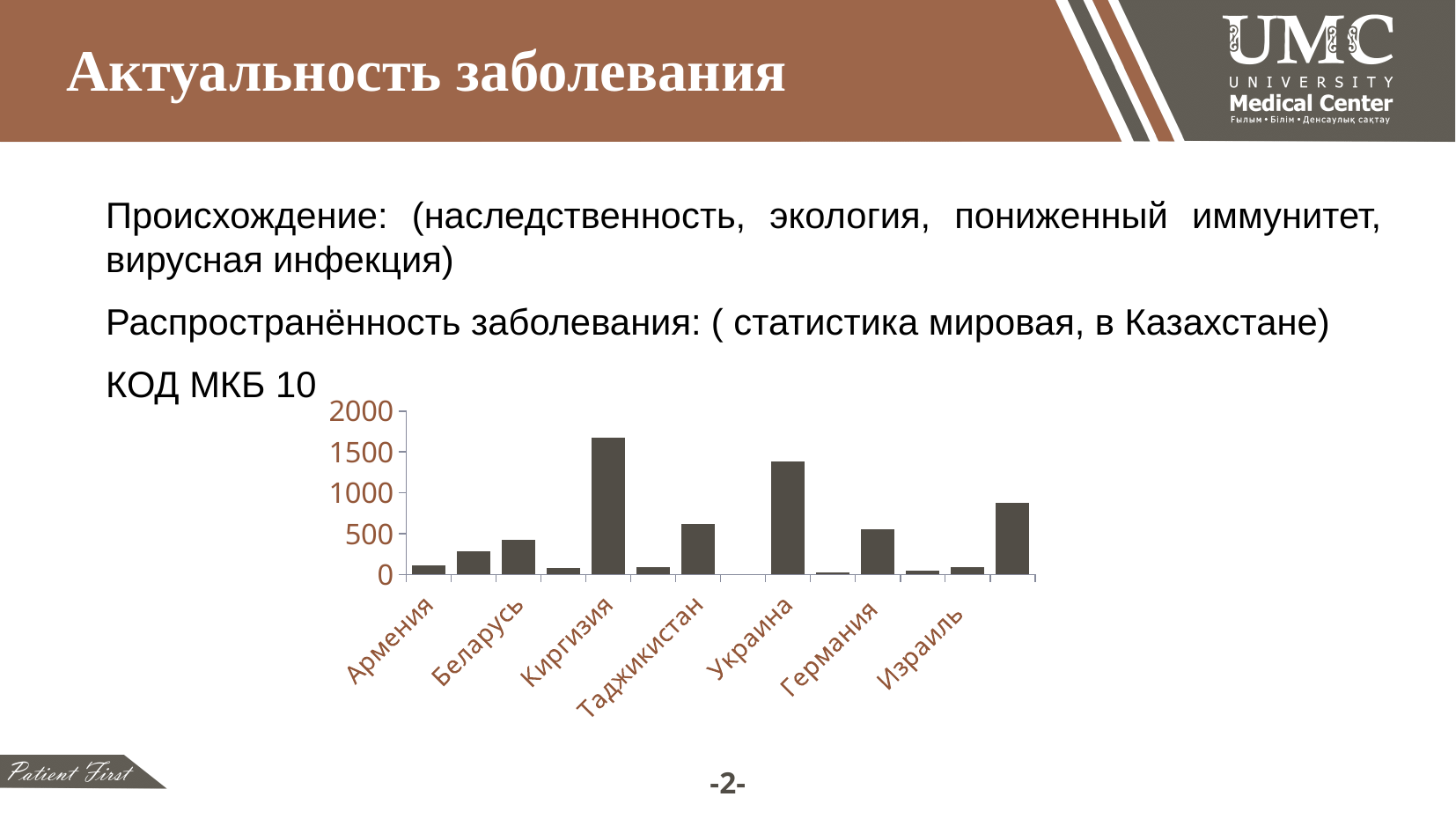
Is the value for Армения greater or less than 500? less Is the value for Киргизия greater or less than 1500? greater Is the value for Таджикистан greater or less than 1000? less What is the highest value shown on the vertical axis of the chart? 2000 Which has the larger value, Таджикистан or Армения? Таджикистан What kind of chart is shown on the slide? bar chart Which labelled country has the highest bar in the chart? Киргизия Which has the larger value, Украина or Германия? Украина Which has the larger value, Киргизия or Украина? Киргизия